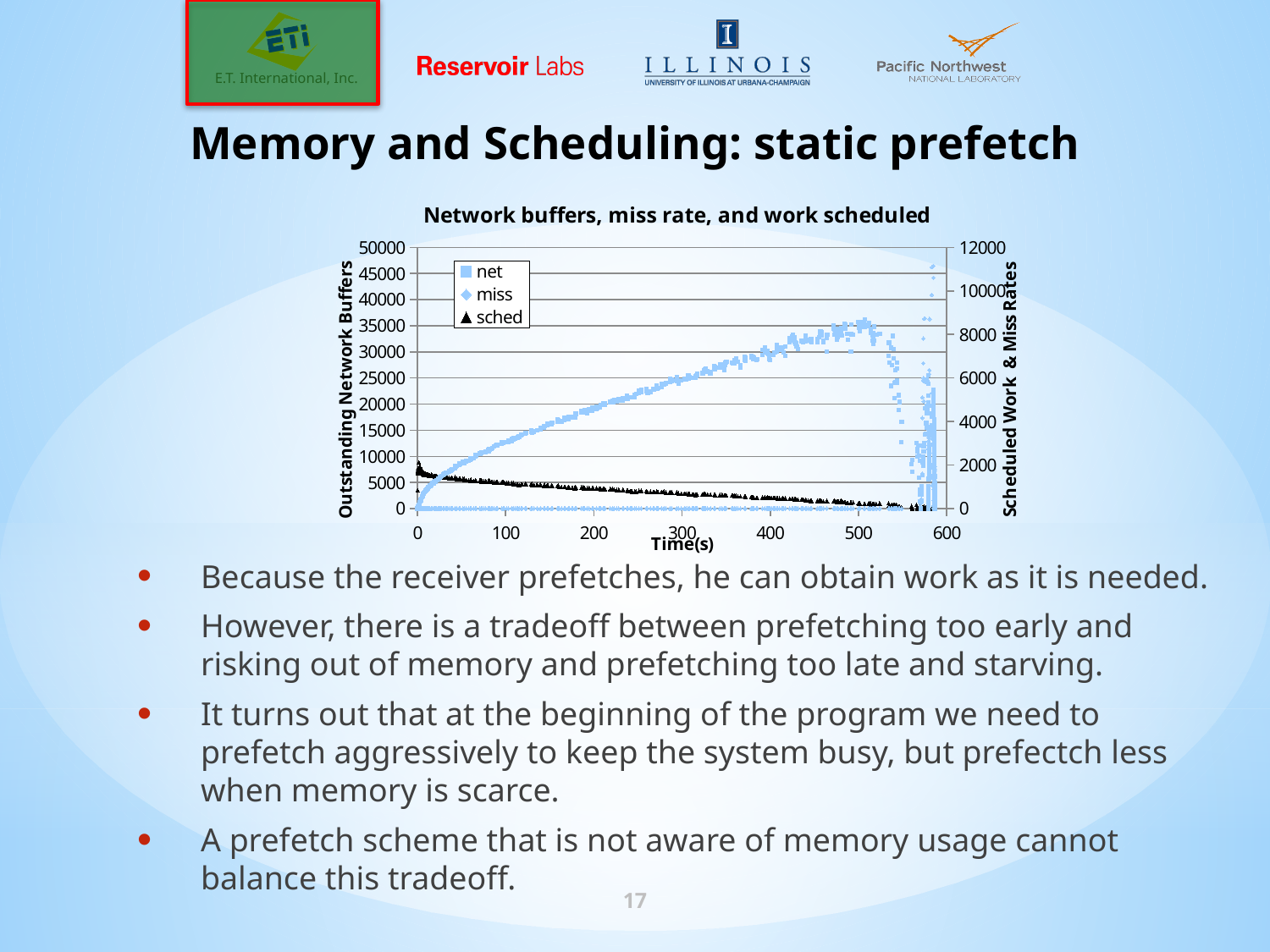
Does the net series rise or fall as time goes from 0 to 500 seconds? rise How many series does the legend of the chart list? 3 Is the value of the net series at time 100 greater or less than 20000 on the left axis? less What kind of chart is shown on the slide? scatter chart Is the value of the net series at time 300 greater or less than 15000 on the left axis? greater What is the title of the chart? Network buffers, miss rate, and work scheduled Is the peak value of the net series greater or less than 30000 on the left axis? greater Does the sched series rise or fall as time increases from 0 to 500 seconds? fall What are the three series named in the chart legend? net, miss, sched